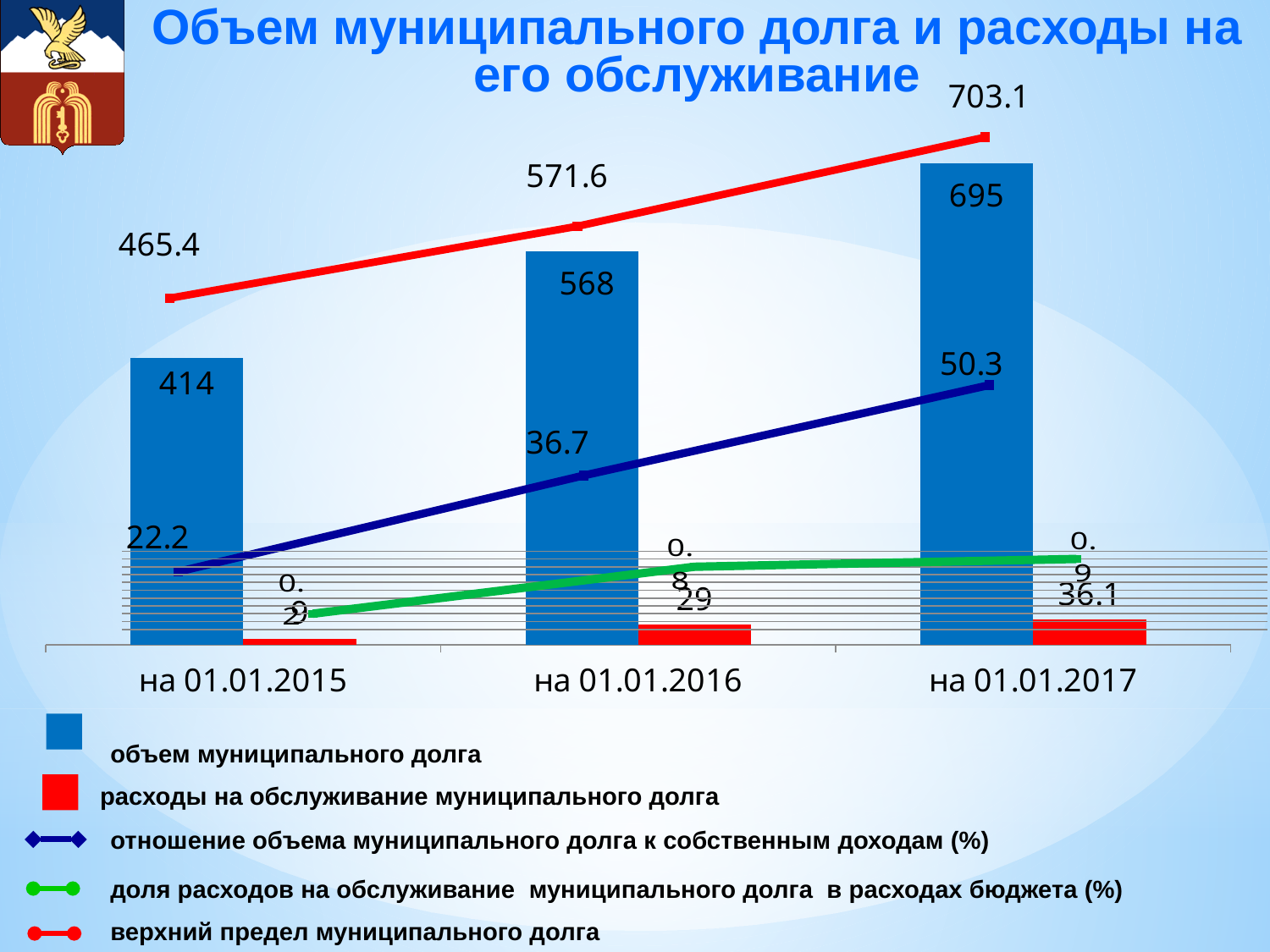
How many dates (categories) are shown on the x axis? 3 On which date is объем муниципального долга the highest? на 01.01.2017 What is the value of объем муниципального долга на 01.01.2016? 568 What is the difference between the верхний предел муниципального долга на 01.01.2017 and на 01.01.2016? 131.5 By how much did объем муниципального долга increase from 01.01.2015 to 01.01.2017? 281 What is the верхний предел муниципального долга на 01.01.2017? 703.1 By how much did the отношение объема муниципального долга к собственным доходам (%) grow from 01.01.2015 to 01.01.2017? 28.1 What kind of chart is shown on the slide? Combined bar and line chart On which date is the верхний предел муниципального долга the lowest? на 01.01.2015 How many series does the legend list? 5 What is the отношение объема муниципального долга к собственным доходам (%) на 01.01.2015? 22.2 What are the расходы на обслуживание муниципального долга на 01.01.2017? 36.1